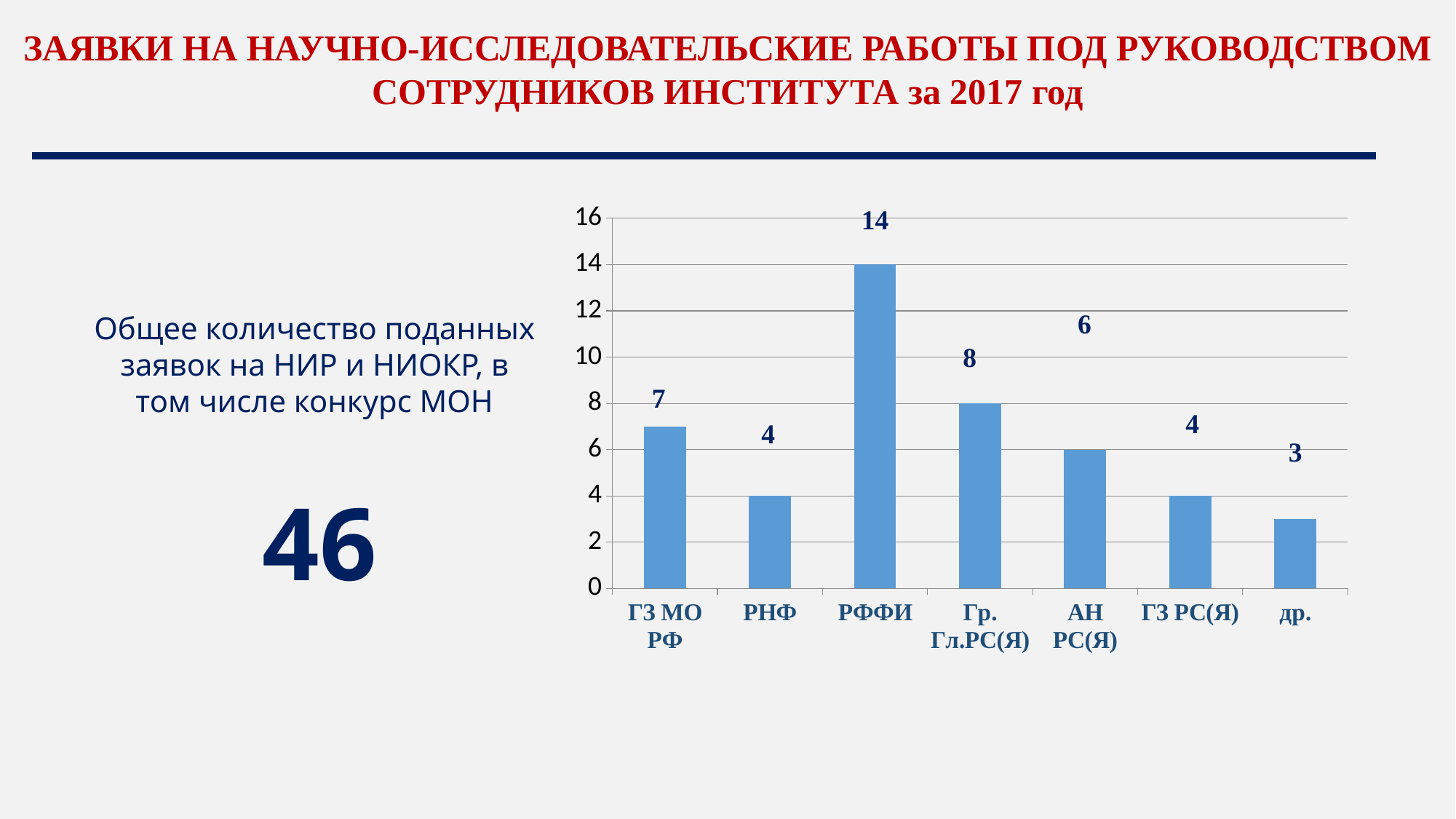
Which is larger, the value for ГЗ МО РФ or the value for РНФ? ГЗ МО РФ Which category has the lowest value? др. What kind of chart is shown on the slide? bar chart What is the value for Гр. Гл.РС(Я)? 8 What is the value for РФФИ? 14 What is the difference between the values for РФФИ and АН РС(Я)? 8 How many categories are shown on the x axis? 7 What is the value for ГЗ МО РФ? 7 Is the value for Гр. Гл.РС(Я) greater or less than 6? greater What is the value for др.? 3 What is the total number of submitted applications stated on the slide? 46 Which category has the highest value? РФФИ